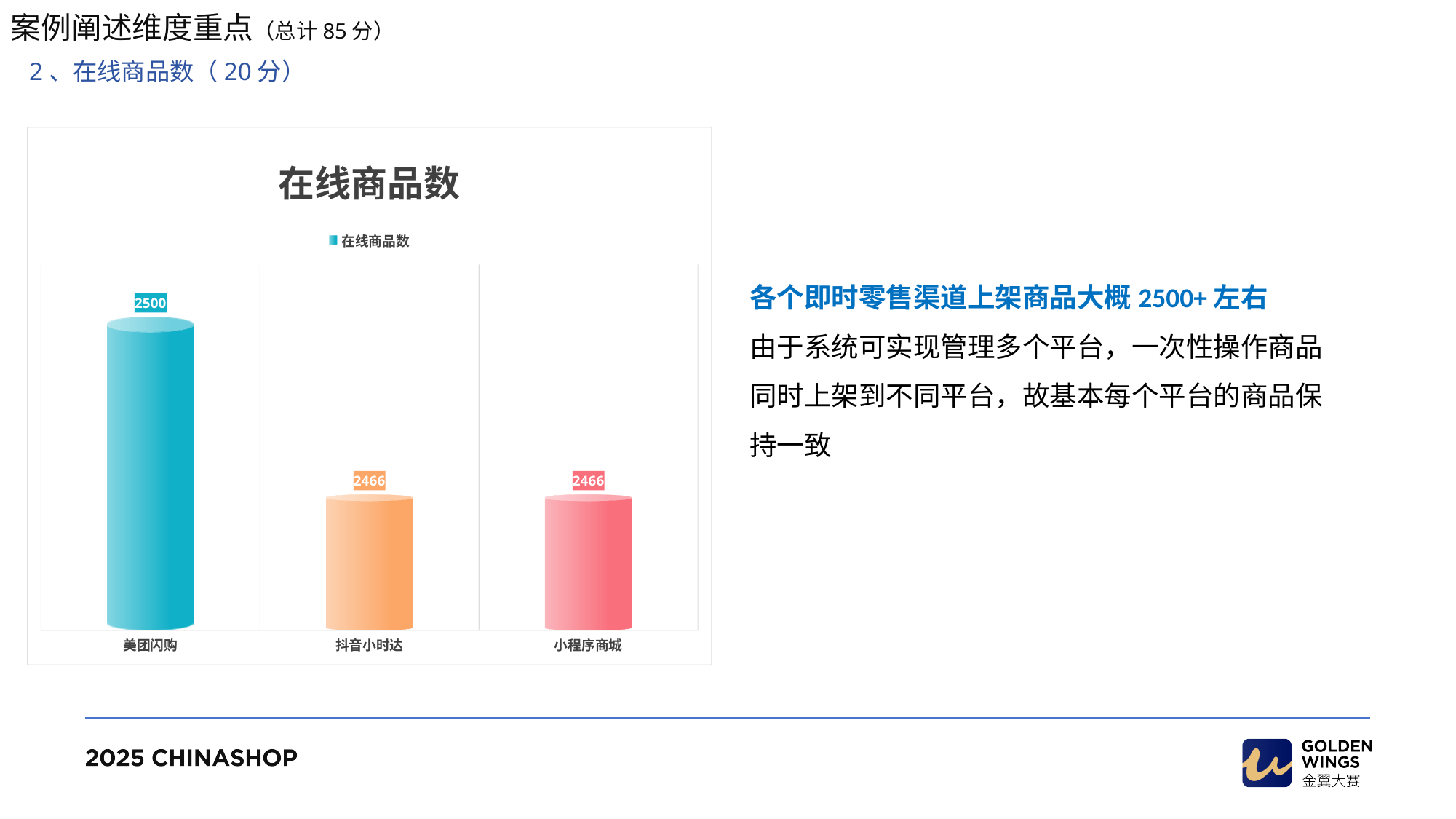
Which is larger, the value for 美团闪购 or the value for 小程序商城? 美团闪购 What is the title of the chart on the slide? 在线商品数 What is the value for 抖音小时达 in the 在线商品数 chart? 2466 How many categories are shown in the 在线商品数 chart? 3 What is the value for 小程序商城 in the 在线商品数 chart? 2466 What is the value for 美团闪购 in the 在线商品数 chart? 2500 What kind of chart is shown on the slide? Bar chart How many series does the legend of the chart list? 1 What is the difference between the values for 美团闪购 and 抖音小时达? 34 Which category has the highest value in the 在线商品数 chart? 美团闪购 Which two categories in the chart have the same value? 抖音小时达 and 小程序商城 What colour is the bar for 抖音小时达? Orange